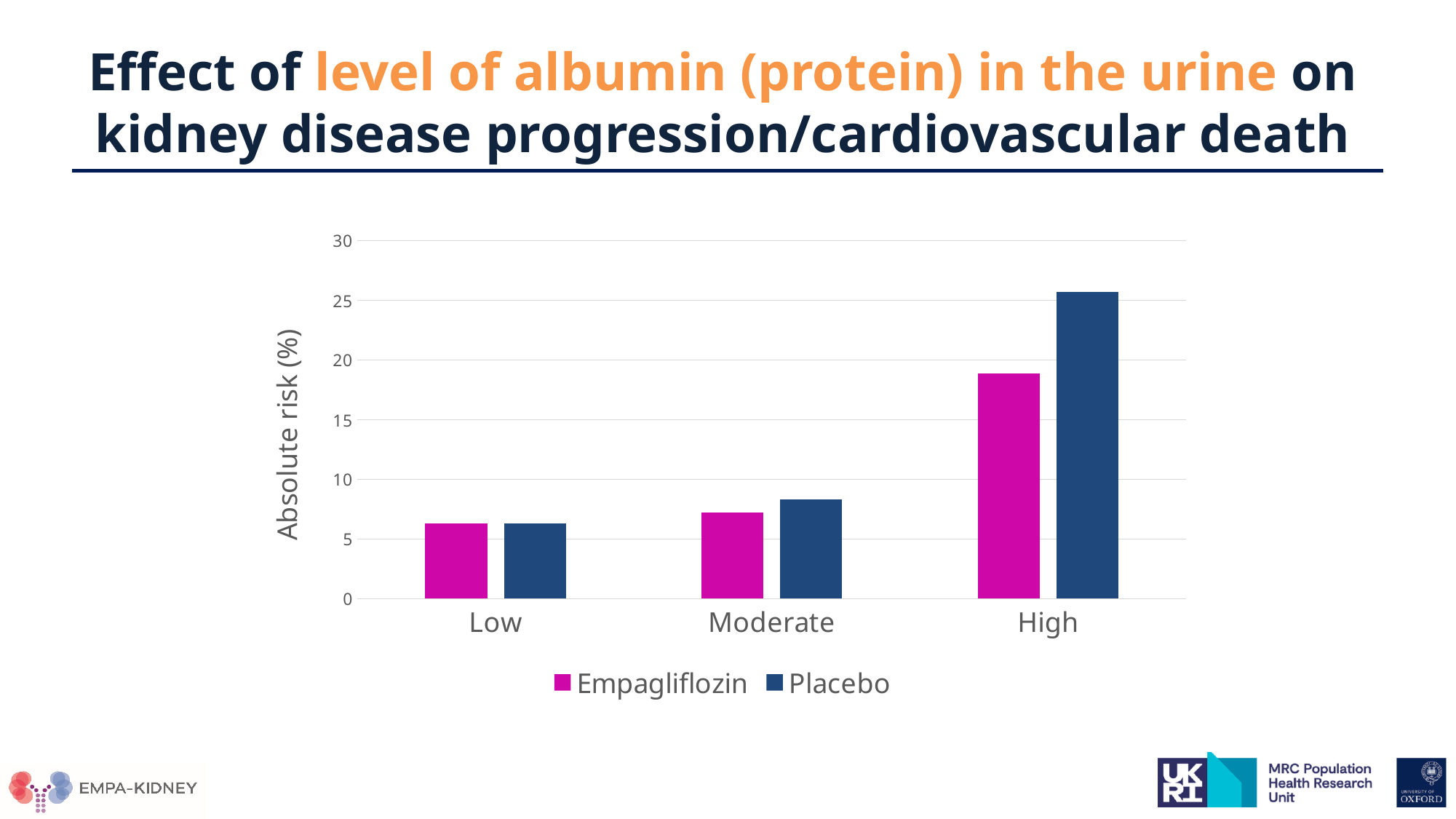
In the Moderate category, which is larger: the Empagliflozin bar or the Placebo bar? Placebo In the High category, which is larger: the Empagliflozin bar or the Placebo bar? Placebo What kind of chart is shown on the slide? Bar chart Is the Placebo value for High greater or less than 20? greater How many albumin level categories are shown on the x axis? 3 Which albumin level category has the highest absolute risk for Placebo? High Do the absolute risk values rise or fall as the albumin level goes from Low to High? Rise What is the label of the y axis? Absolute risk (%) How many series does the legend list? 2 Which albumin level category has the lowest absolute risk for Empagliflozin? Low Is the Placebo value for Moderate greater or less than 10? less Is the Empagliflozin value for High greater or less than 15? greater